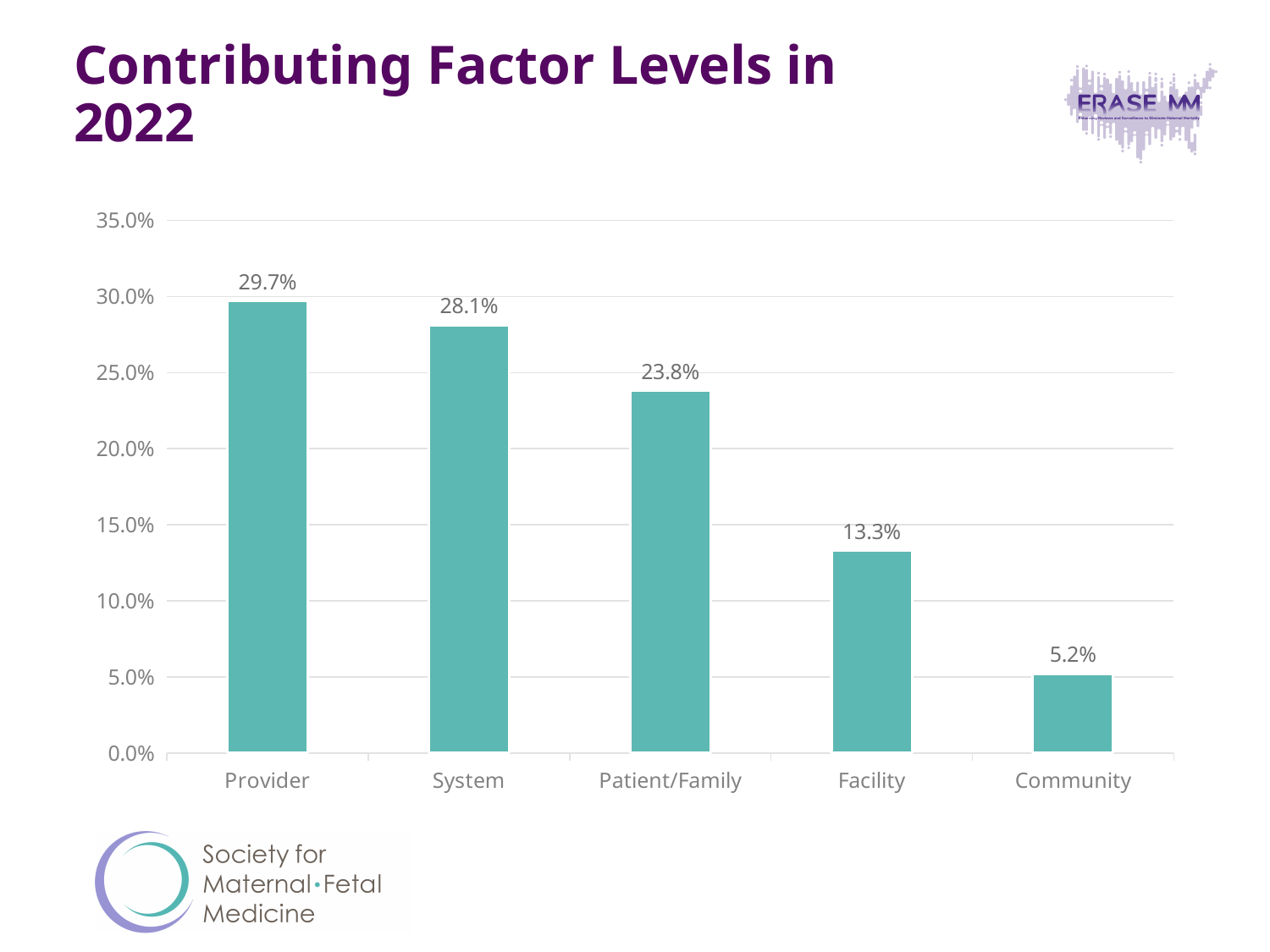
What is the difference between the values for Provider and System? 1.6% What is the value for Facility? 13.3% What kind of chart is shown on the slide? bar chart Which category has the highest value? Provider Is the value for Facility greater or less than 15.0%? less What is the value for Community? 5.2% How many categories are shown on the x axis? 5 What is the value for Provider? 29.7% Which category has the lowest value? Community Do the values rise or fall from left to right along the x axis? fall What is the difference between the values for Patient/Family and Facility? 10.5% Which is larger, the value for System or the value for Patient/Family? System